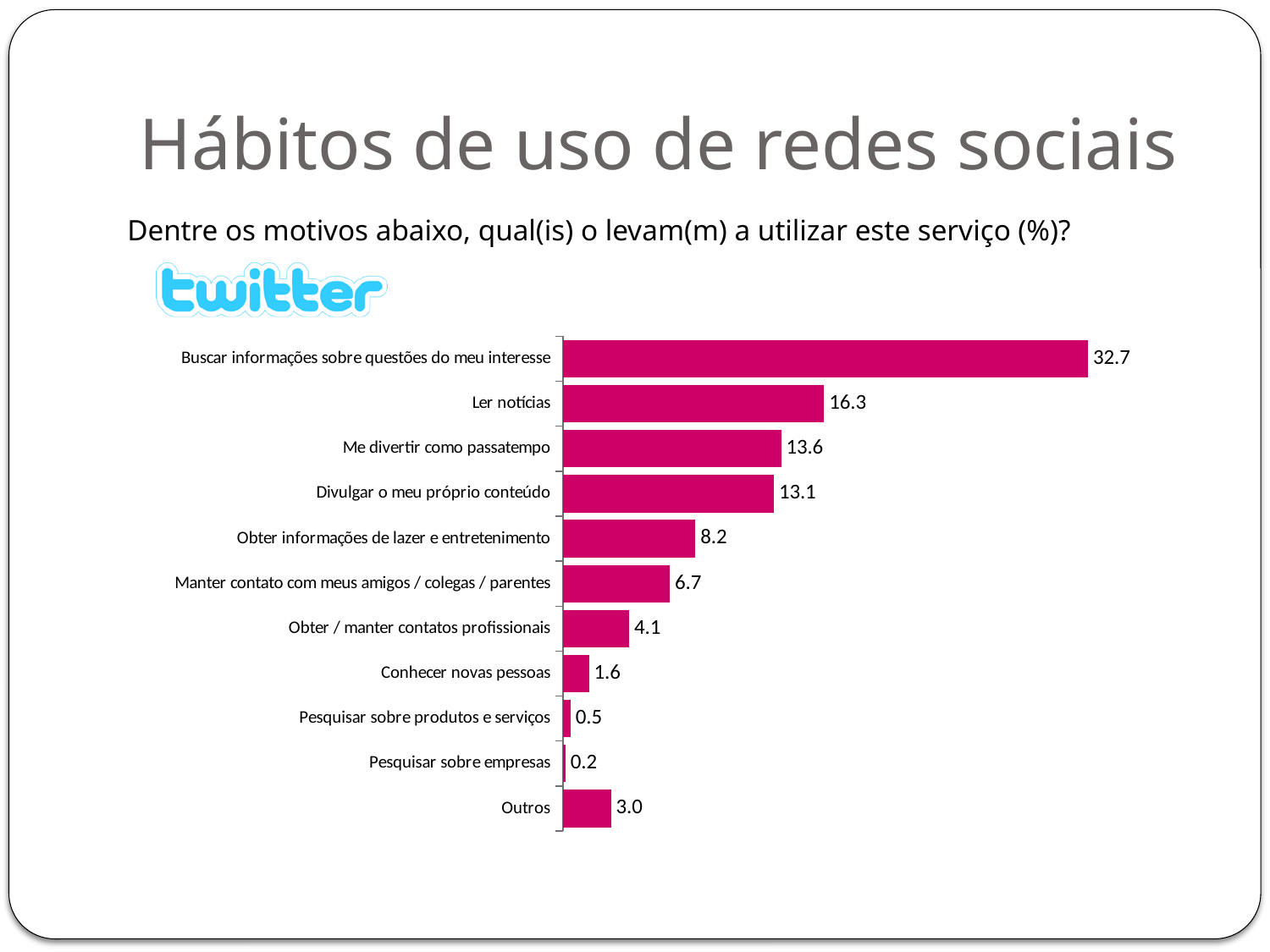
What kind of chart is shown on the slide? Bar chart What is the value for "Outros"? 3.0 How many categories are shown in the chart? 11 Which category has the lowest value? Pesquisar sobre empresas Which social network does the chart refer to? Twitter What is the difference between the values for "Me divertir como passatempo" and "Divulgar o meu próprio conteúdo"? 0.5 What is the value for "Ler notícias"? 16.3 Which category has the highest value? Buscar informações sobre questões do meu interesse What is the value for "Obter informações de lazer e entretenimento"? 8.2 What is the difference between the values for "Buscar informações sobre questões do meu interesse" and "Ler notícias"? 16.4 Which is larger, the value for "Outros" or the value for "Conhecer novas pessoas"? Outros Which is larger, the value for "Manter contato com meus amigos / colegas / parentes" or the value for "Obter / manter contatos profissionais"? Manter contato com meus amigos / colegas / parentes